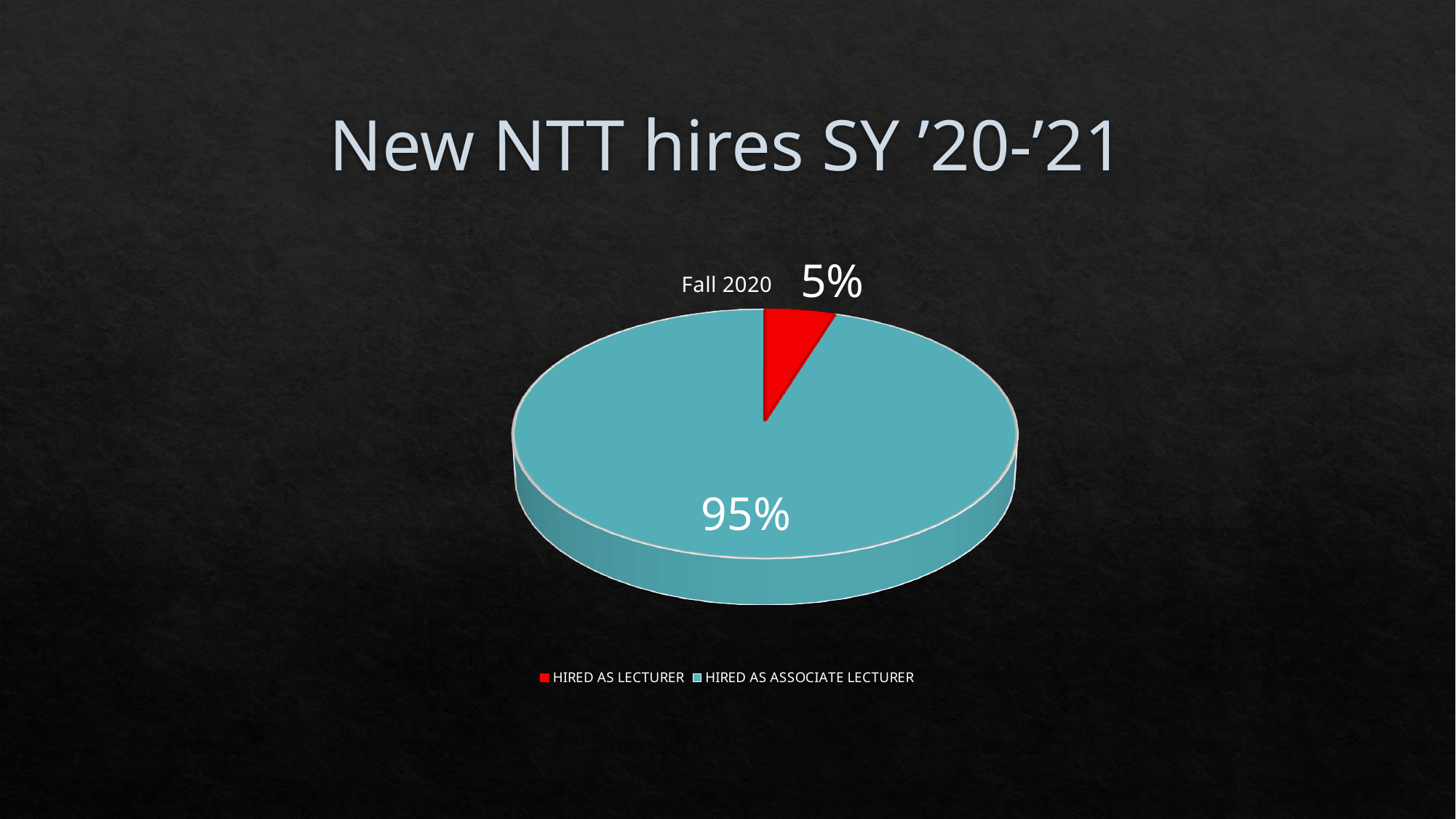
What is the difference in percentage points between the associate lecturer share and the lecturer share? 90 How many slices does the pie chart have? 2 What is the title of the slide? New NTT hires SY '20-'21 What colour is the slice for hired as lecturer? Red Which is larger: the share hired as lecturer or the share hired as associate lecturer? Hired as associate lecturer Which category has the largest slice of the pie? Hired as associate lecturer What share of the pie is labelled for hired as lecturer? 5% What is the chart's title shown above the pie? Fall 2020 What kind of chart is shown on the slide? Pie chart What share of the pie is labelled for hired as associate lecturer? 95% How many entries does the legend list? 2 Which category has the smallest slice of the pie? Hired as lecturer